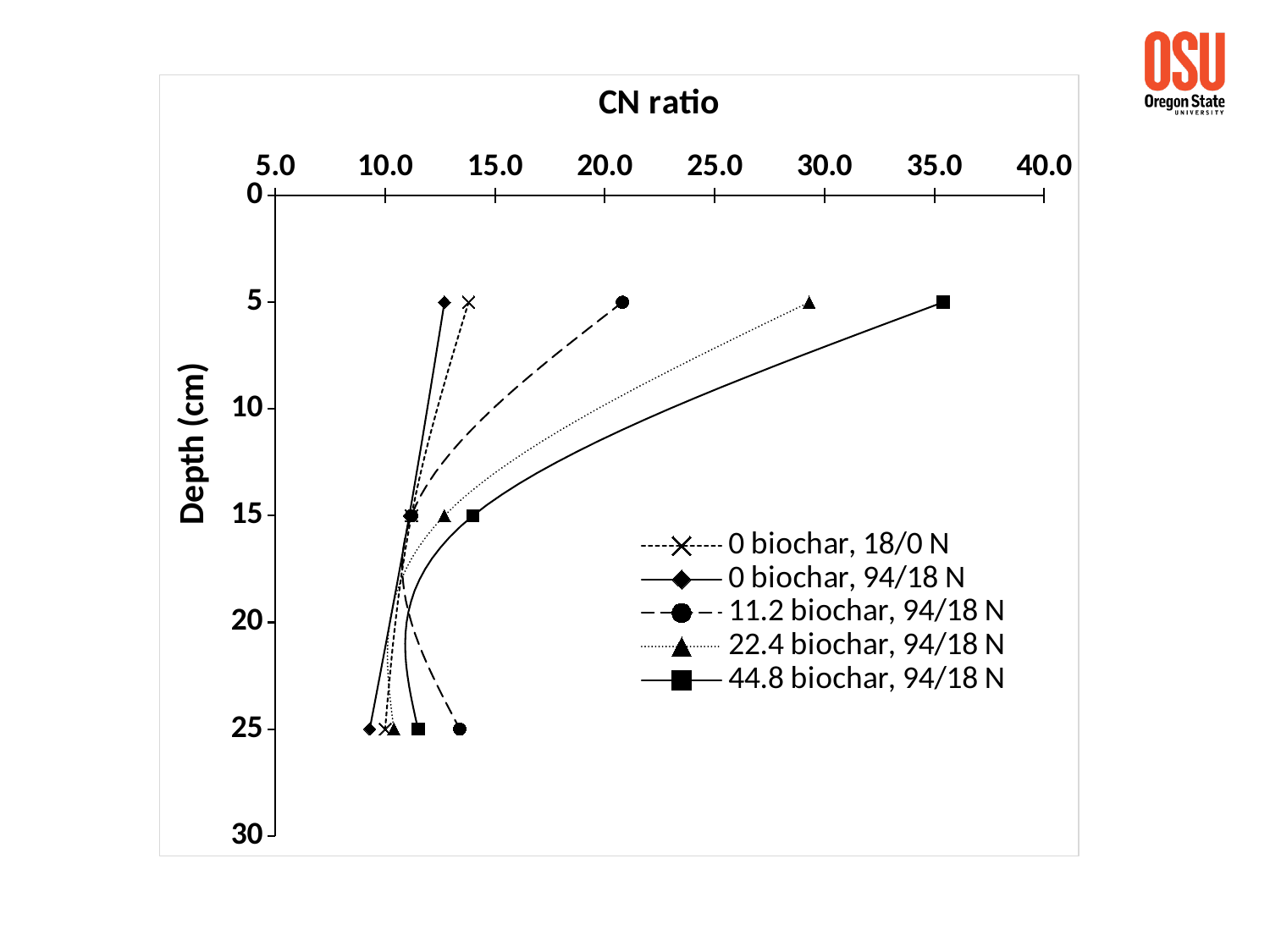
What kind of chart is shown on the slide? line chart At a depth of 5 cm, which has the larger CN ratio: 44.8 biochar, 94/18 N or 11.2 biochar, 94/18 N? 44.8 biochar, 94/18 N Which series has the highest CN ratio at a depth of 5 cm? 44.8 biochar, 94/18 N For the 44.8 biochar, 94/18 N series, does the CN ratio rise or fall as depth increases from 5 cm to 25 cm? fall How many depth points are plotted for each series? 3 Is the CN ratio for 0 biochar, 18/0 N at a depth of 5 cm greater or less than 15.0? less Is the CN ratio for 44.8 biochar, 94/18 N at a depth of 5 cm greater or less than 30.0? greater How many series does the legend list? 5 What is the label of the vertical axis? Depth (cm) Is the CN ratio for 0 biochar, 94/18 N at a depth of 25 cm greater or less than 10.0? less Which series has the highest CN ratio at a depth of 25 cm? 11.2 biochar, 94/18 N What is the title of the chart? CN ratio